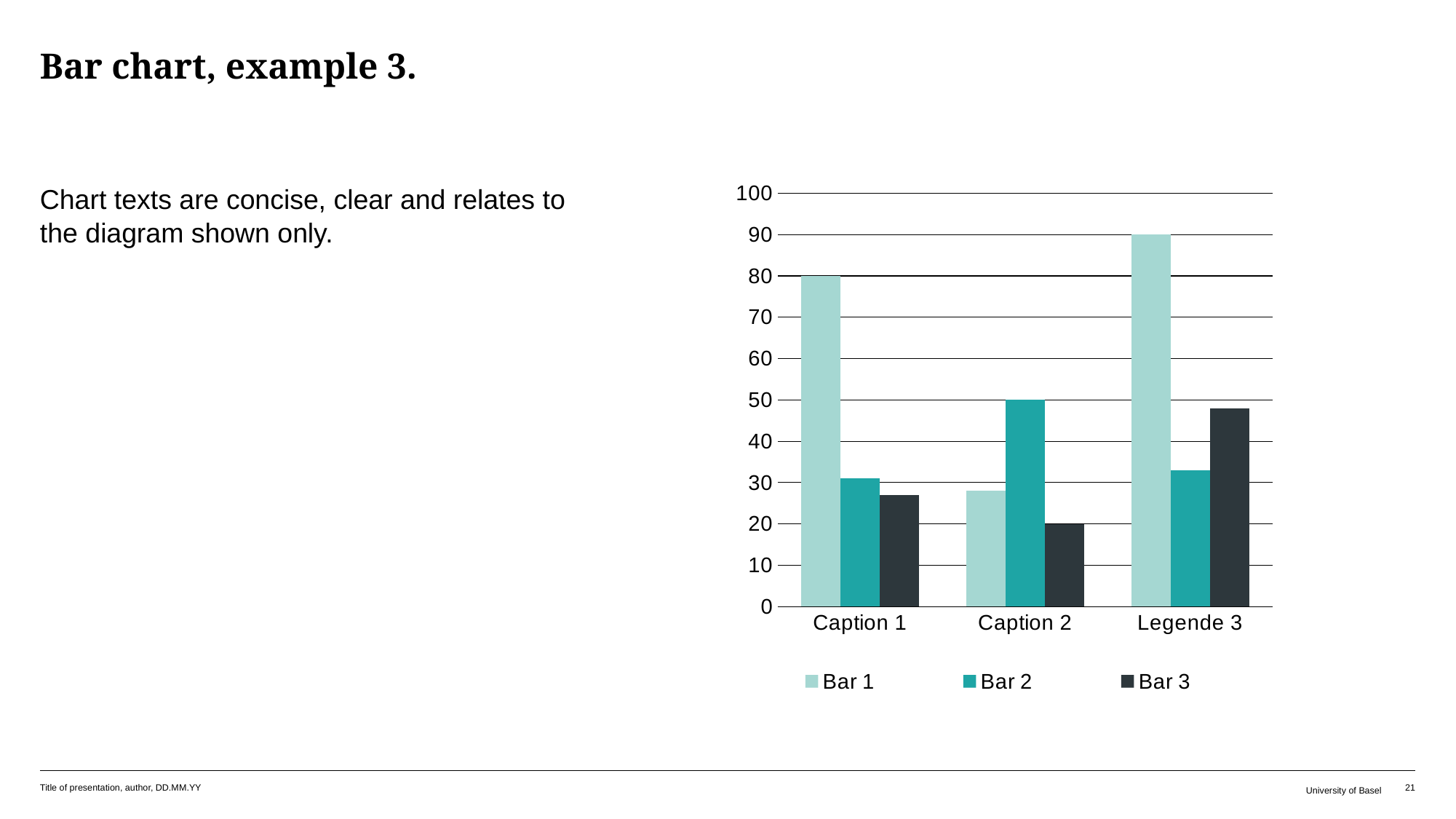
Is the value of Bar 1 for Caption 2 greater or less than 30? less Which category has the lowest Bar 3 value? Caption 2 What is the value of Bar 3 for Caption 2? 20 What is the value of Bar 1 for Legende 3? 90 Which is larger for Caption 1: Bar 2 or Bar 3? Bar 2 What is the value of Bar 2 for Caption 2? 50 What is the difference between the Bar 1 values for Legende 3 and Caption 1? 10 What is the value of Bar 1 for Caption 1? 80 Is the value of Bar 3 for Legende 3 greater or less than 40? greater Which category has the highest Bar 1 value? Legende 3 What kind of chart is shown on the slide? Bar chart How many series does the legend list? 3